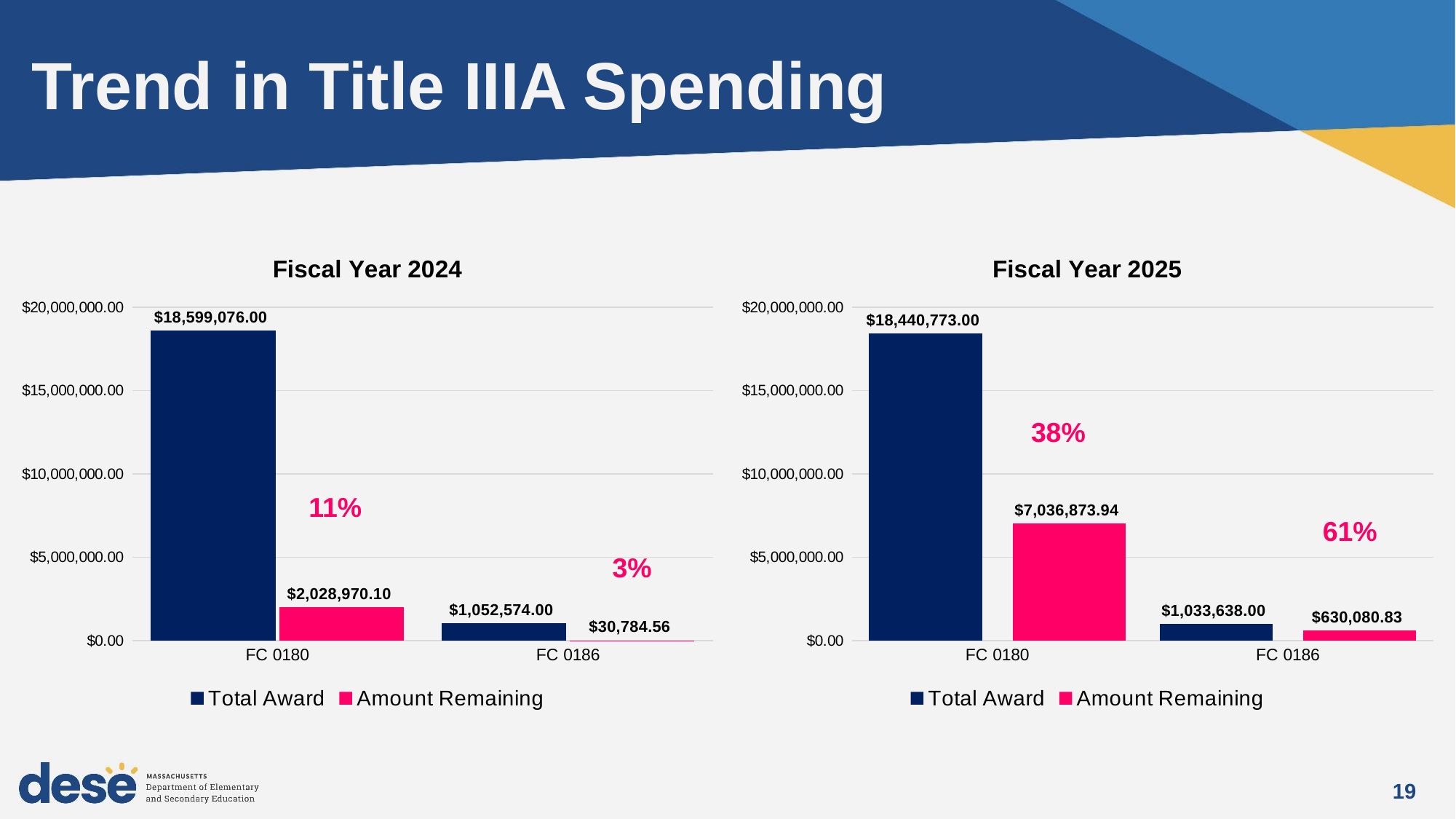
In the Fiscal Year 2025 chart, what is the difference between the Total Award and the Amount Remaining for FC 0180? $11,403,899.06 In the Fiscal Year 2024 chart, what is the Amount Remaining for FC 0186? $30,784.56 In the Fiscal Year 2025 chart, what percentage label is shown above the FC 0186 bars? 61% In the Fiscal Year 2024 chart, what is the Total Award for FC 0180? $18,599,076.00 How many series does the legend of the Fiscal Year 2025 chart list? 2 In the Fiscal Year 2024 chart, is the Total Award for FC 0180 greater or less than $15,000,000.00? greater Which is larger: the Amount Remaining for FC 0180 in the Fiscal Year 2024 chart or in the Fiscal Year 2025 chart? Fiscal Year 2025 What type of chart is the Fiscal Year 2024 chart? bar chart In the Fiscal Year 2025 chart, what is the Amount Remaining for FC 0180? $7,036,873.94 In the Fiscal Year 2025 chart, what is the Total Award for FC 0186? $1,033,638.00 In the Fiscal Year 2024 chart, which category has the highest Total Award? FC 0180 In the Fiscal Year 2025 chart, which category has the lowest Amount Remaining? FC 0186